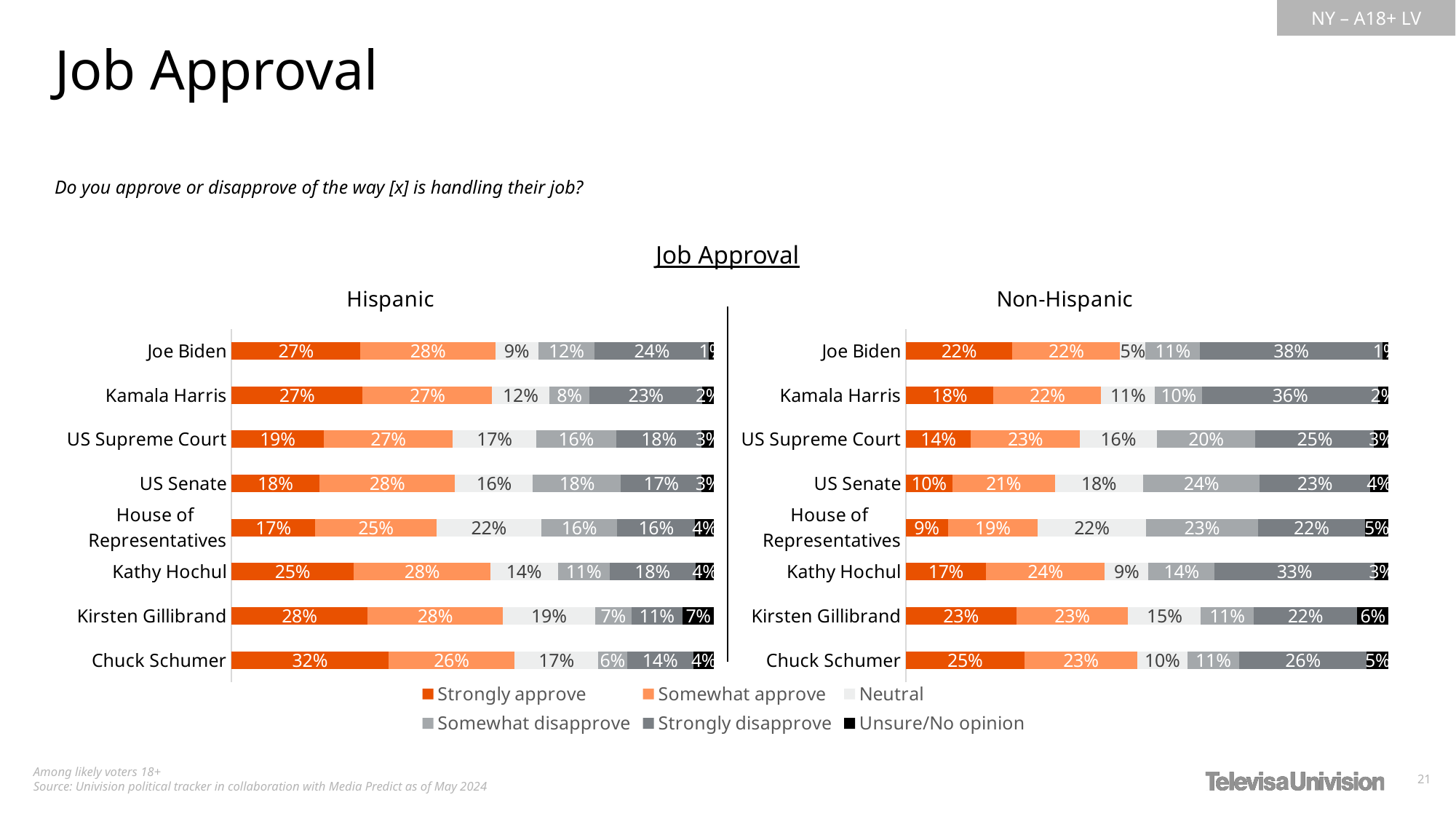
In the Hispanic chart, which category has the highest Strongly approve value? Chuck Schumer In the Non-Hispanic chart, what percentage strongly disapprove of Joe Biden? 38% How many series does the legend list? 6 How many categories are shown in the Hispanic chart? 8 In the Non-Hispanic chart, which category has the lowest Strongly approve value? House of Representatives In the Hispanic chart, which is larger: the Strongly approve value for Kathy Hochul or for Kirsten Gillibrand? Kirsten Gillibrand What kind of chart is used for the Hispanic and Non-Hispanic panels? Stacked bar chart In the Hispanic chart, what percentage strongly approve of Chuck Schumer? 32% In the Non-Hispanic chart, what is the Neutral value for the House of Representatives? 22% What is the last entry in the legend? Unsure/No opinion In the Hispanic chart, what is the total of the US Supreme Court bar? 100% In the Non-Hispanic chart, what is the difference between the Strongly disapprove values for Joe Biden and Kamala Harris? 2%